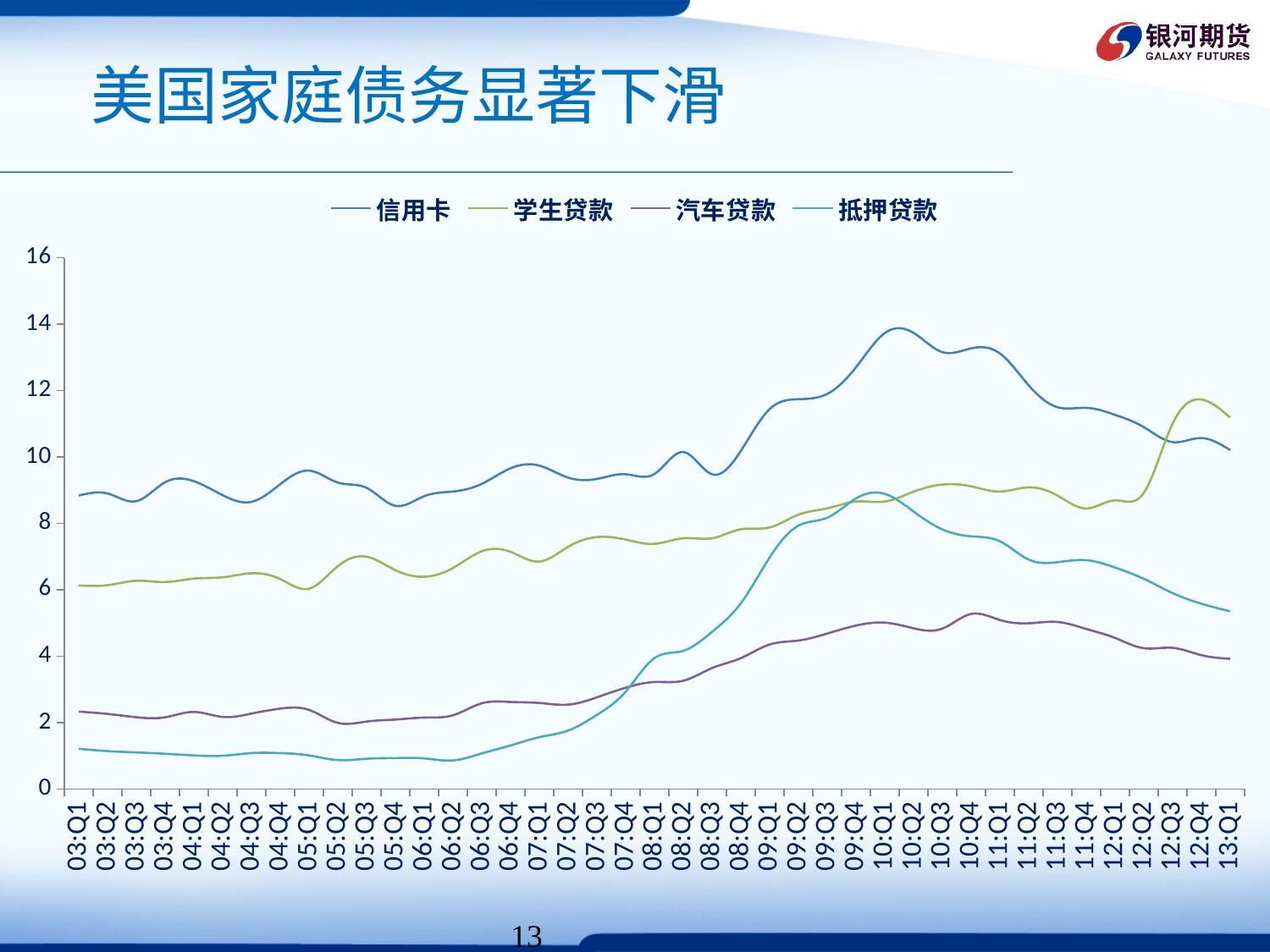
How many quarterly points are shown along the x axis, from 03:Q1 to 13:Q1? 41 Is the value for 抵押贷款 at 03:Q1 greater or less than 2? less Which series is plotted with the green line? 学生贷款 At 13:Q1, which is larger, 学生贷款 or 信用卡? 学生贷款 How many series does the legend list? 4 Is the value for 信用卡 at 10:Q1 greater or less than 12? greater What is the title of the chart on the slide? 美国家庭债务显著下滑 Is the value for 抵押贷款 at 13:Q1 greater or less than 6? less Does the 抵押贷款 line rise or fall from 09:Q4 to 13:Q1? fall What kind of chart is shown on the slide? line chart Which series has the highest value at 10:Q1? 信用卡